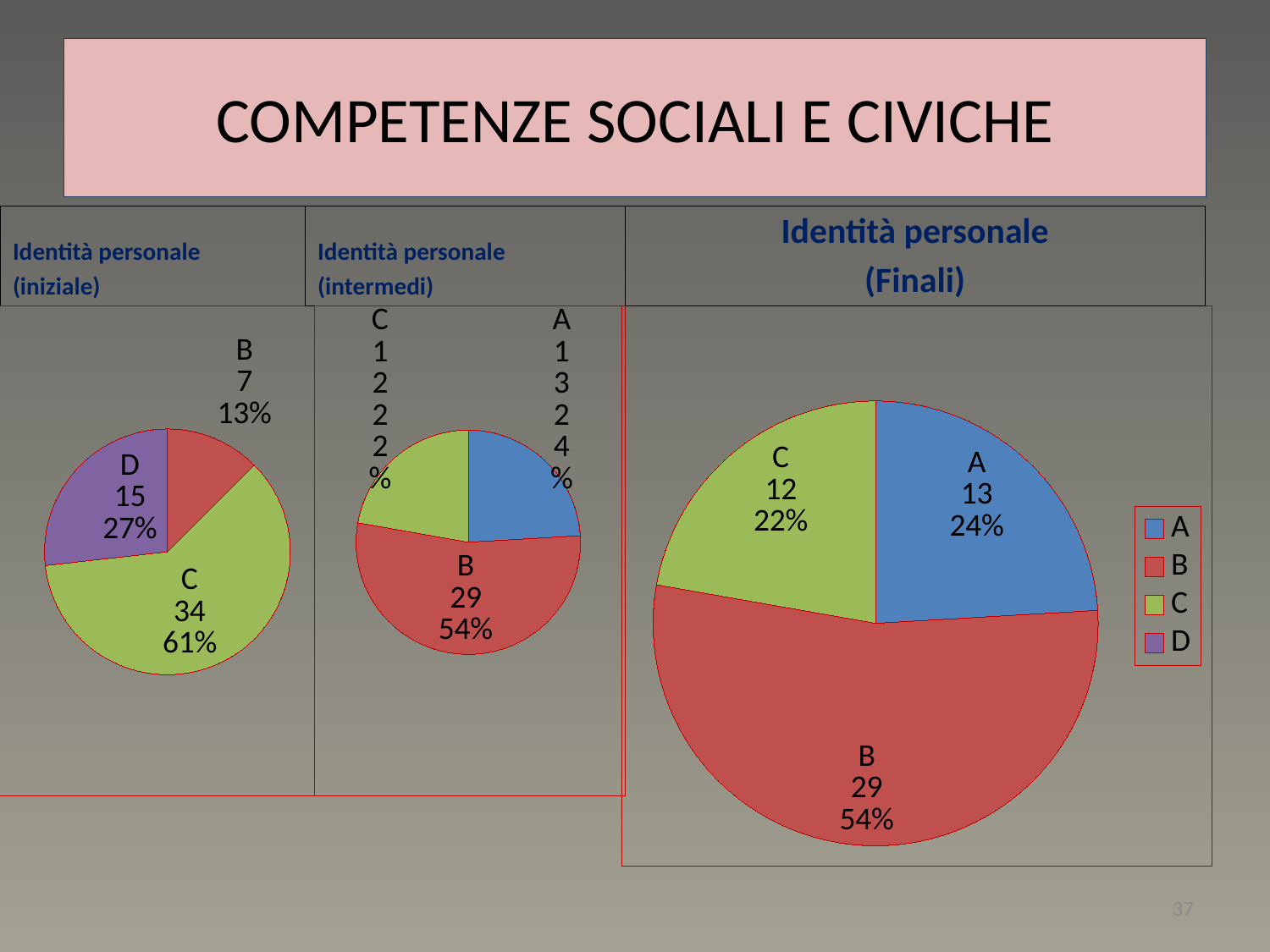
In the 'Identità personale (intermedi)' chart, which category has the largest slice? B In the 'Identità personale (Finali)' chart, what is the difference between the values for B and A? 16 In the 'Identità personale (intermedi)' chart, what value is shown for category B? 29 In the 'Identità personale (iniziale)' chart, what percentage is shown for category D? 27% In the 'Identità personale (iniziale)' chart, which category has the smallest slice? B In the 'Identità personale (Finali)' chart, which is larger, the value for A or the value for C? A In the 'Identità personale (iniziale)' chart, what value is shown for category C? 34 In the 'Identità personale (iniziale)' chart, what is the difference between the values for C and D? 19 In the 'Identità personale (Finali)' chart, what value is shown for category C? 12 In the 'Identità personale (Finali)' chart, what percentage is shown for category A? 24% In the 'Identità personale (iniziale)' chart, how many slices does the pie have? 3 How many entries does the legend next to the 'Identità personale (Finali)' chart list? 4